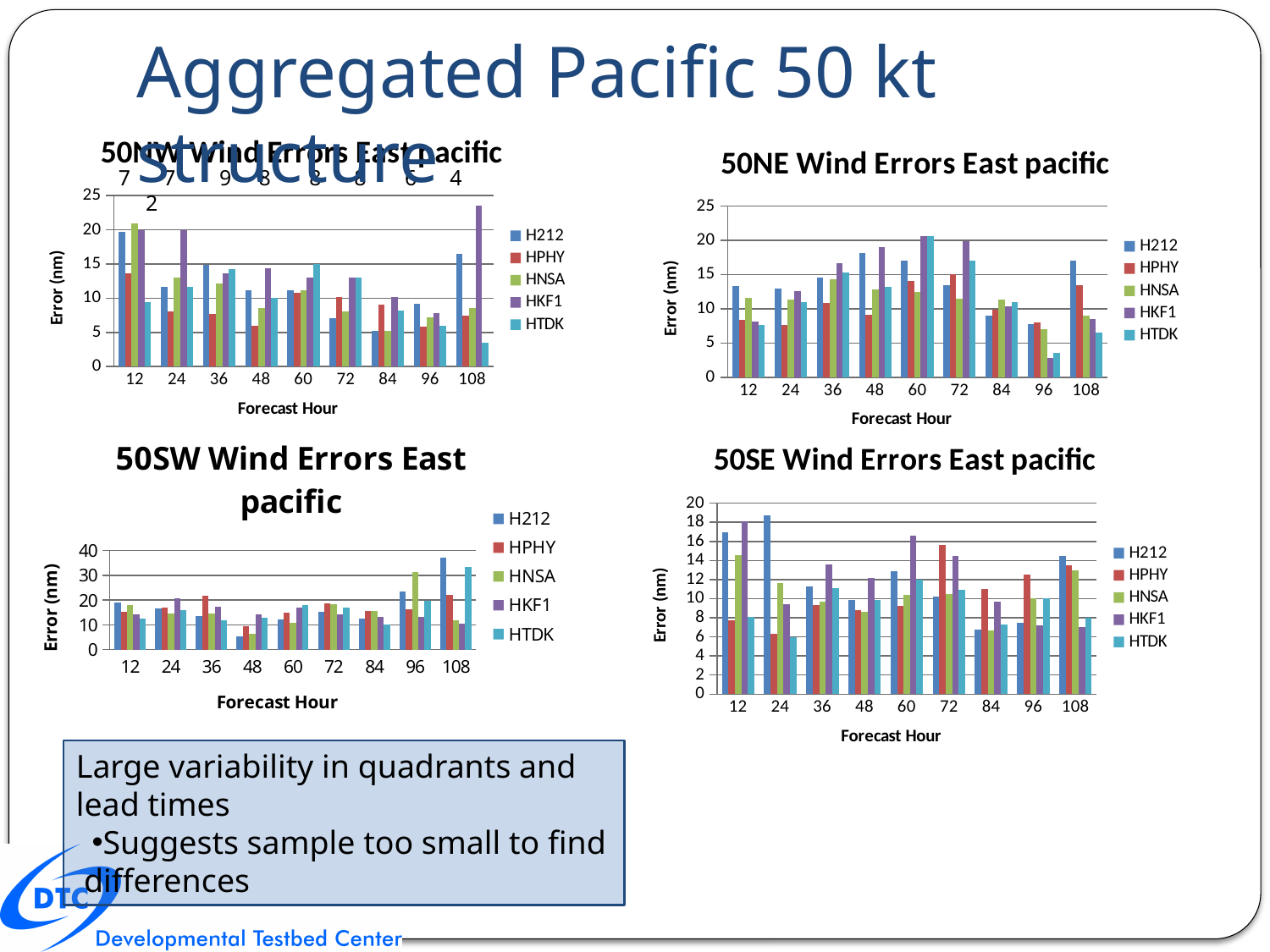
In the "50SW Wind Errors East pacific" chart, which is larger: the H212 value at forecast hour 108 or the H212 value at forecast hour 12? forecast hour 108 In the "50NE Wind Errors East pacific" chart, is the HTDK value at forecast hour 96 greater or less than 5? less How many forecast hour categories are shown on the x axis of the "50SE Wind Errors East pacific" chart? 9 In the "50NE Wind Errors East pacific" chart, is the H212 value at forecast hour 48 greater or less than 15? greater In the "50SE Wind Errors East pacific" chart, is the HPHY value at forecast hour 24 greater or less than 8? less How many series does the legend of the "50NE Wind Errors East pacific" chart list? 5 What type of chart is the "50NW Wind Errors East pacific" chart? bar chart In the "50NW Wind Errors East pacific" chart, which series has the highest bar at forecast hour 108? HKF1 What is the label on the y axis of the "50SW Wind Errors East pacific" chart? Error (nm)